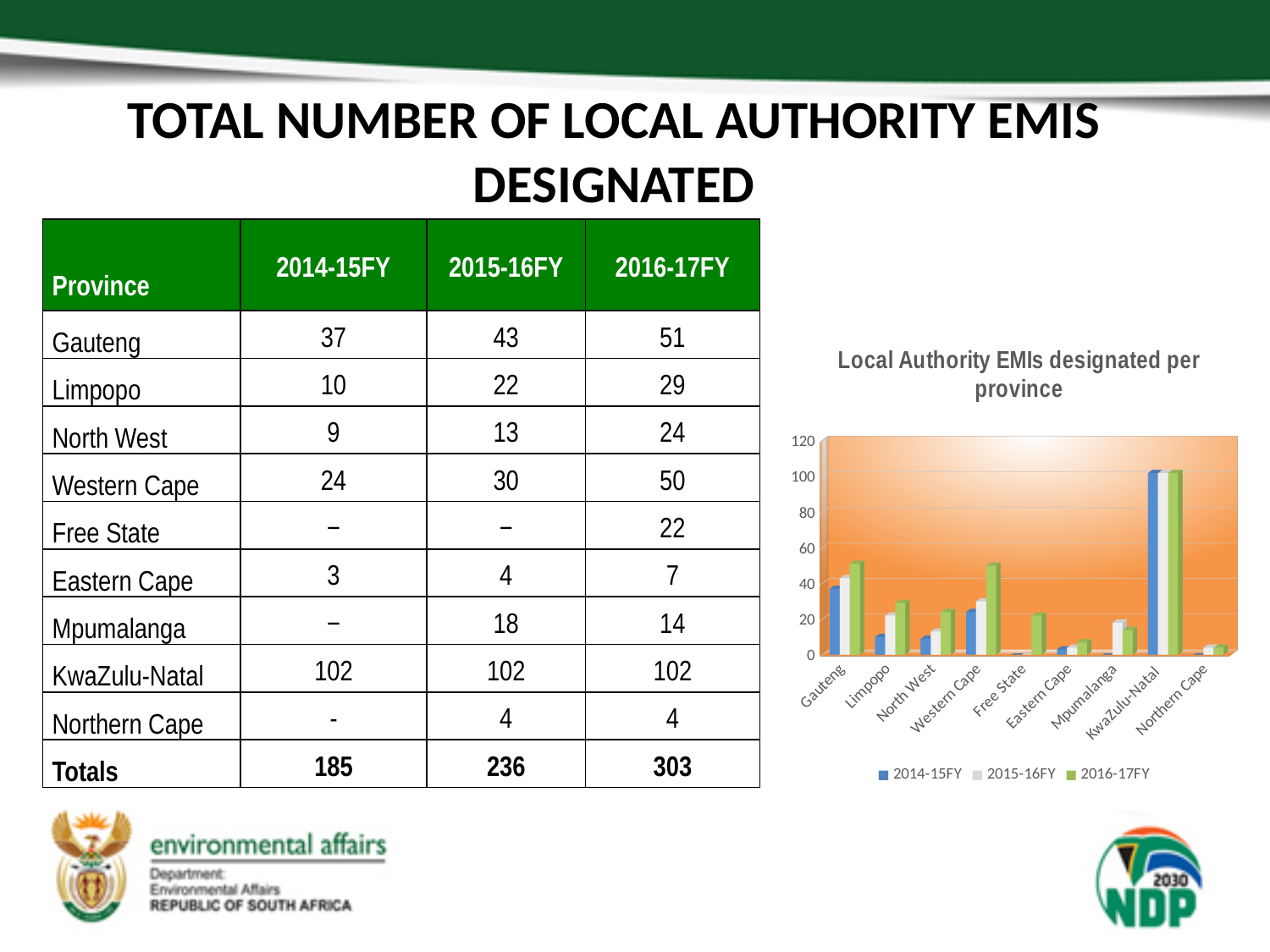
What is the 2016-17FY value for Western Cape? 50 What is the title of the chart? Local Authority EMIs designated per province What is the difference between Gauteng's 2016-17FY value and its 2014-15FY value? 14 For 2016-17FY, which is larger: Limpopo or North West? Limpopo In the chart, is the 2016-17FY value for Gauteng greater or less than 40? greater What kind of chart is shown on the slide? bar chart Do Gauteng's values rise or fall from 2014-15FY to 2016-17FY? rise Which colour represents the 2016-17FY series in the chart? green In the chart, is the 2014-15FY value for KwaZulu-Natal greater or less than 80? greater Which province has the highest bar for 2016-17FY in the chart? KwaZulu-Natal How many series does the chart legend list? 3 How many provinces are shown along the x axis of the chart? 9